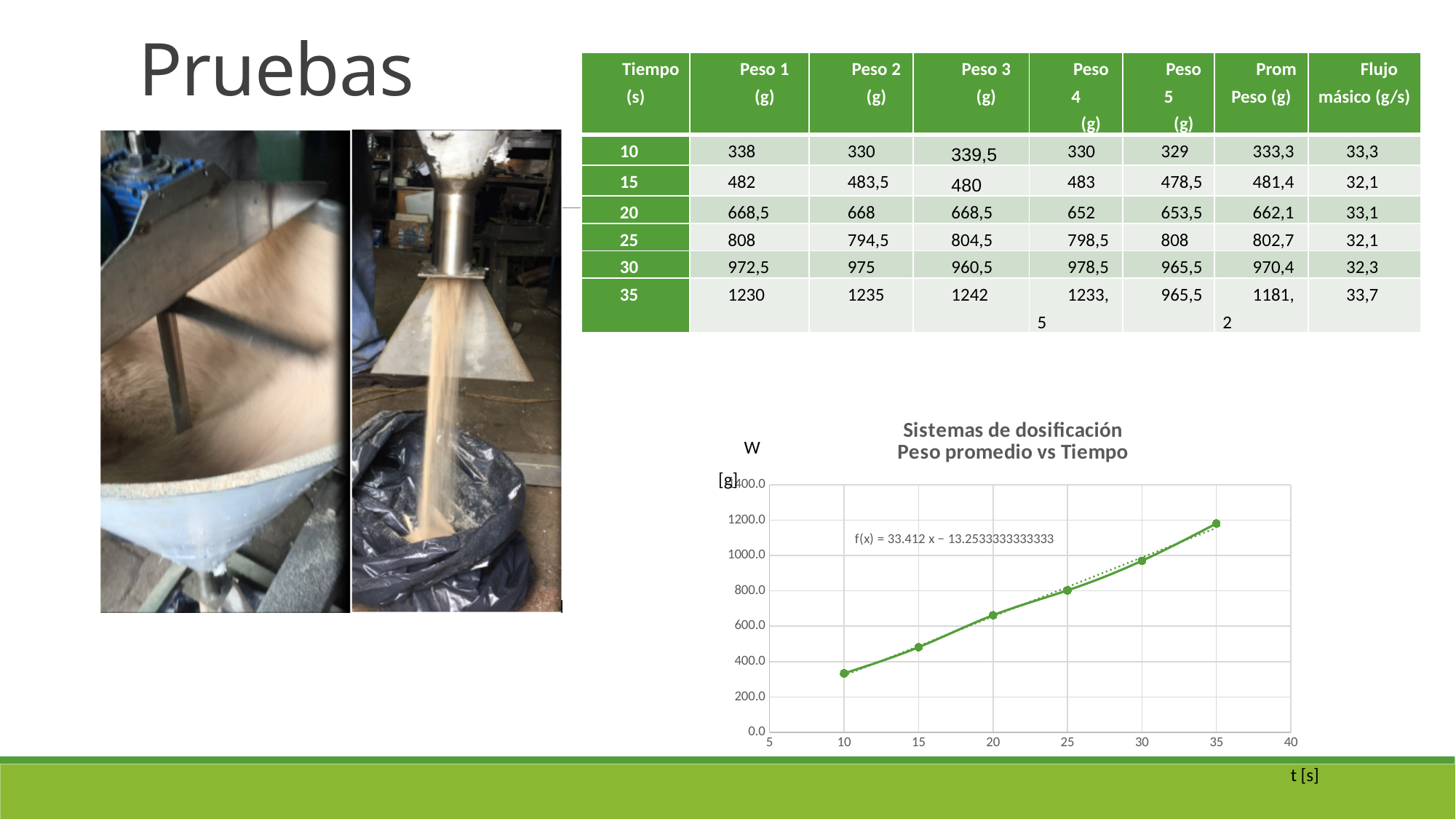
Is the plotted value at t = 15 greater or less than 400? greater What trendline equation is displayed on the chart? f(x) = 33.412 x − 13.2533333333333 Is the plotted value at t = 10 greater or less than 400? less Do the plotted values rise or fall as time increases along the x axis? rise How many data points are plotted on the chart? 6 Is the plotted value at t = 35 greater or less than 1000? greater At which time value is the plotted weight highest? 35 What is the title of the chart? Sistemas de dosificación Peso promedio vs Tiempo What kind of chart is shown on the slide? line chart At which time value is the plotted weight lowest? 10 Which has the larger plotted value, t = 20 or t = 30? t = 30